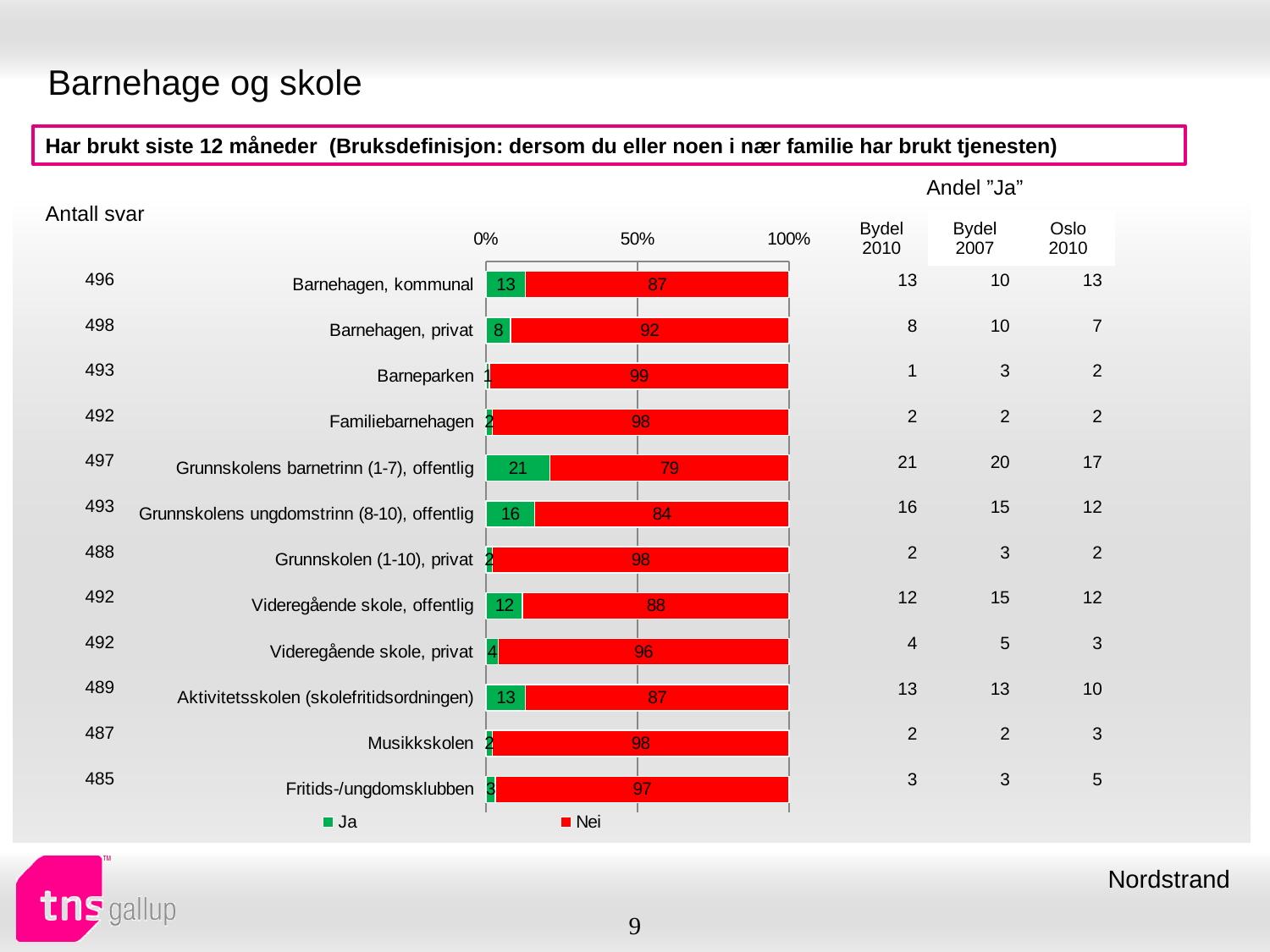
How many series does the chart legend list? 2 What kind of chart is shown on the slide? bar chart What is the difference between the "Ja" values for Grunnskolens barnetrinn (1-7), offentlig and Grunnskolens ungdomstrinn (8-10), offentlig? 5 How many categories are plotted in the chart? 12 What is the total of the stacked bar for Aktivitetsskolen (skolefritidsordningen)? 100 Which category has the lowest "Ja" value? Barneparken Which category has the highest "Ja" value? Grunnskolens barnetrinn (1-7), offentlig What is the "Ja" value for Grunnskolens barnetrinn (1-7), offentlig? 21 What are the two entries in the chart legend? Ja, Nei What is the "Nei" value for Barnehagen, privat? 92 Which has a larger "Ja" value: Barnehagen, kommunal or Barnehagen, privat? Barnehagen, kommunal What is the "Ja" value for Videregående skole, offentlig? 12